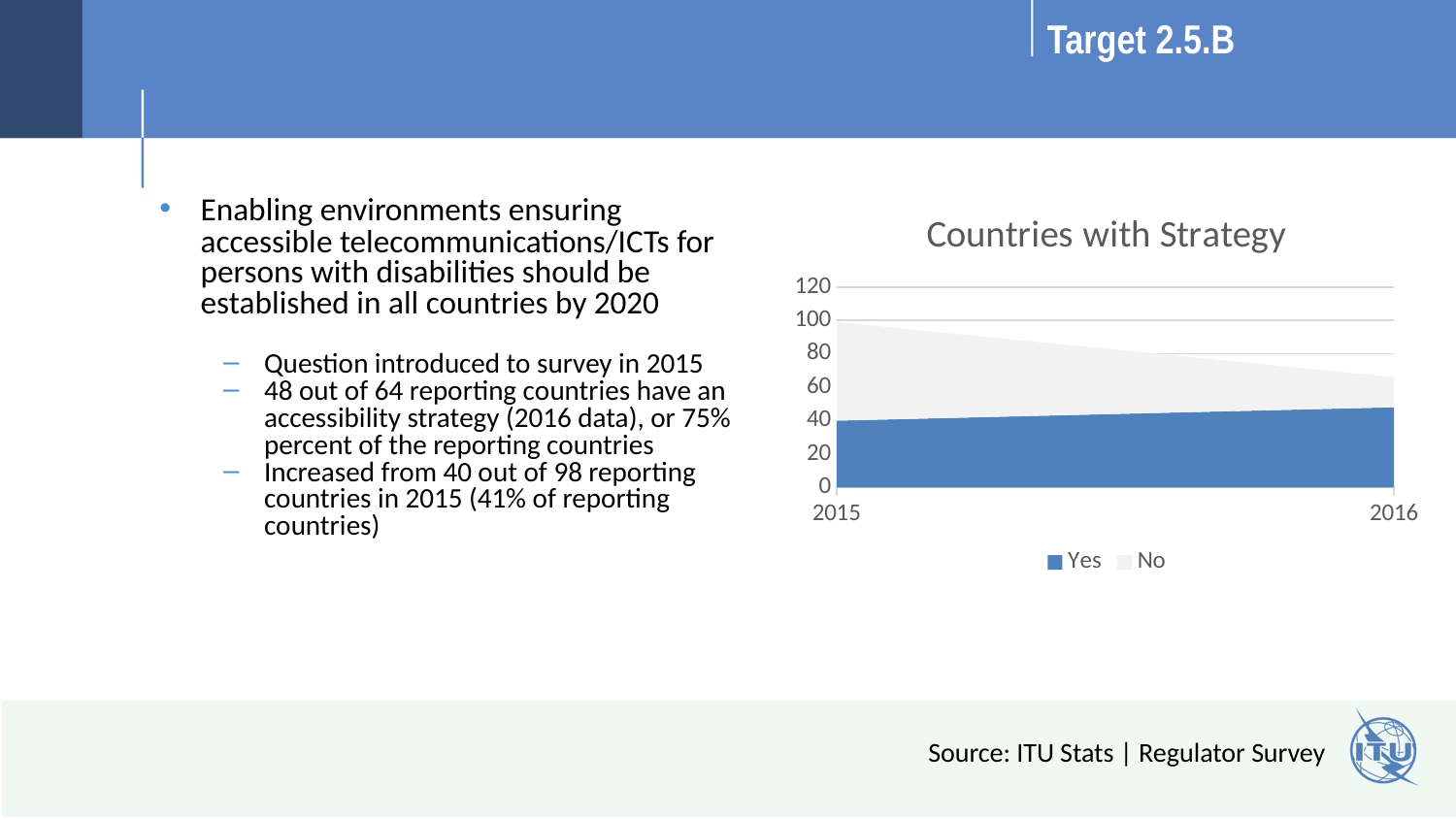
In the 'Countries with Strategy' chart, is the 'Yes' value for 2015 greater or less than 60? less In the 'Countries with Strategy' chart, does the 'Yes' series rise or fall from 2015 to 2016? Rise What kind of chart is 'Countries with Strategy'? Area chart In the 'Countries with Strategy' chart, is the combined top of the stacked areas in 2016 greater or less than 80? less How many series does the legend of the 'Countries with Strategy' chart list? 2 In the 'Countries with Strategy' chart, does the total of the stacked areas rise or fall from 2015 to 2016? Fall How many years are shown on the x axis of the 'Countries with Strategy' chart? 2 In the 'Countries with Strategy' chart, is the combined top of the stacked areas in 2015 greater or less than 80? greater What is the title of the chart on the slide? Countries with Strategy What are the two series named in the legend of the 'Countries with Strategy' chart? Yes and No Which years are shown on the x axis of the 'Countries with Strategy' chart? 2015 and 2016